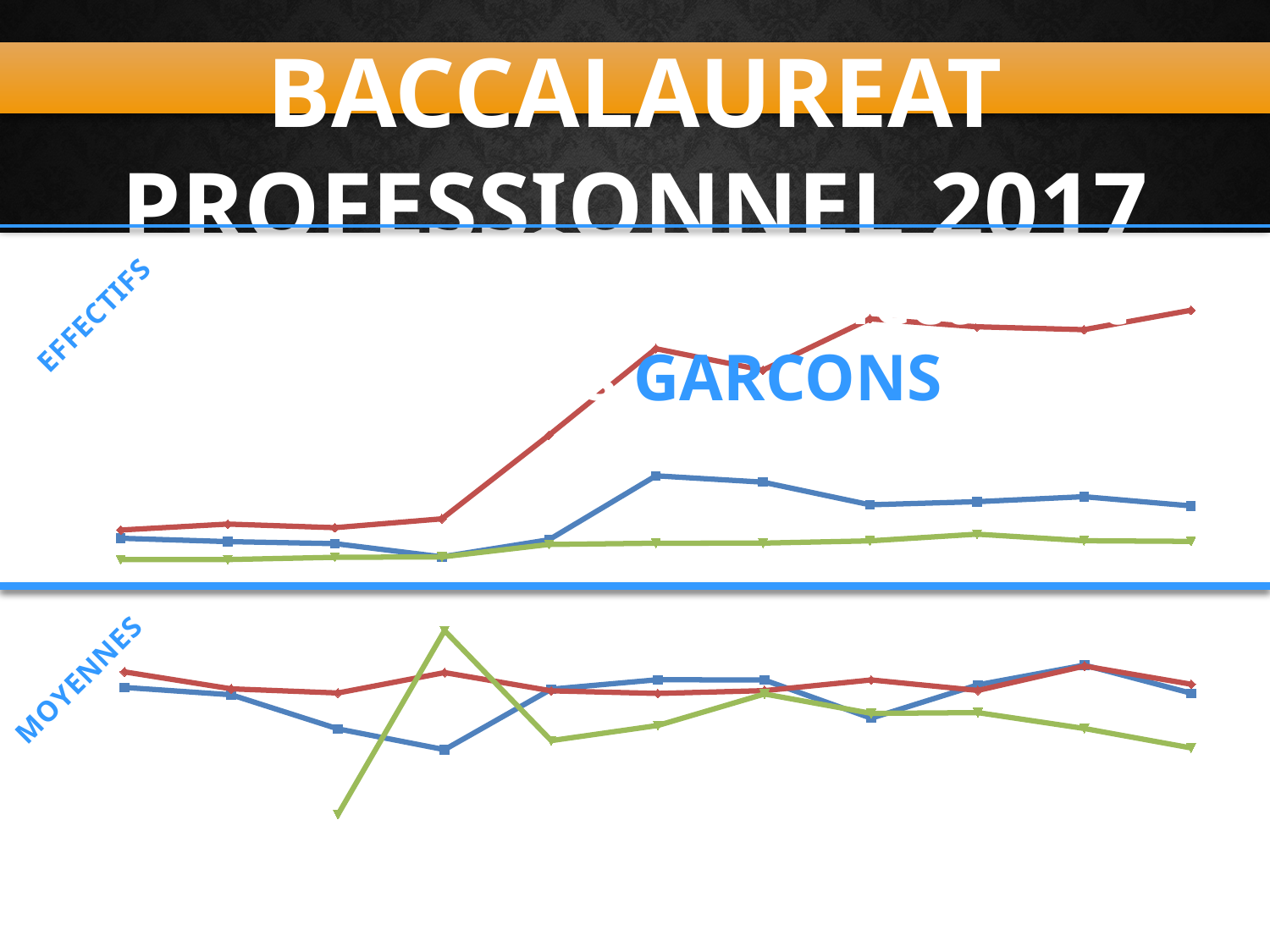
What is the label of the bottom chart on the slide? MOYENNES How many lines are plotted in the bottom chart labelled MOYENNES? 3 How many data points does the blue line have in the bottom chart labelled MOYENNES? 11 In the top chart labelled EFFECTIFS, which coloured line is lowest at the right-hand end? green What kind of chart is the top chart labelled EFFECTIFS? line chart What kind of chart is the bottom chart labelled MOYENNES? line chart In the top chart labelled EFFECTIFS, which coloured line is highest at the right-hand end? red How many data points does the red line have in the top chart labelled EFFECTIFS? 11 What word is written in large blue letters over the top chart? GARCONS How many lines are plotted in the top chart labelled EFFECTIFS? 3 In the top chart labelled EFFECTIFS, does the red line overall rise or fall from left to right? rise How many data points does the green line have in the bottom chart labelled MOYENNES? 9